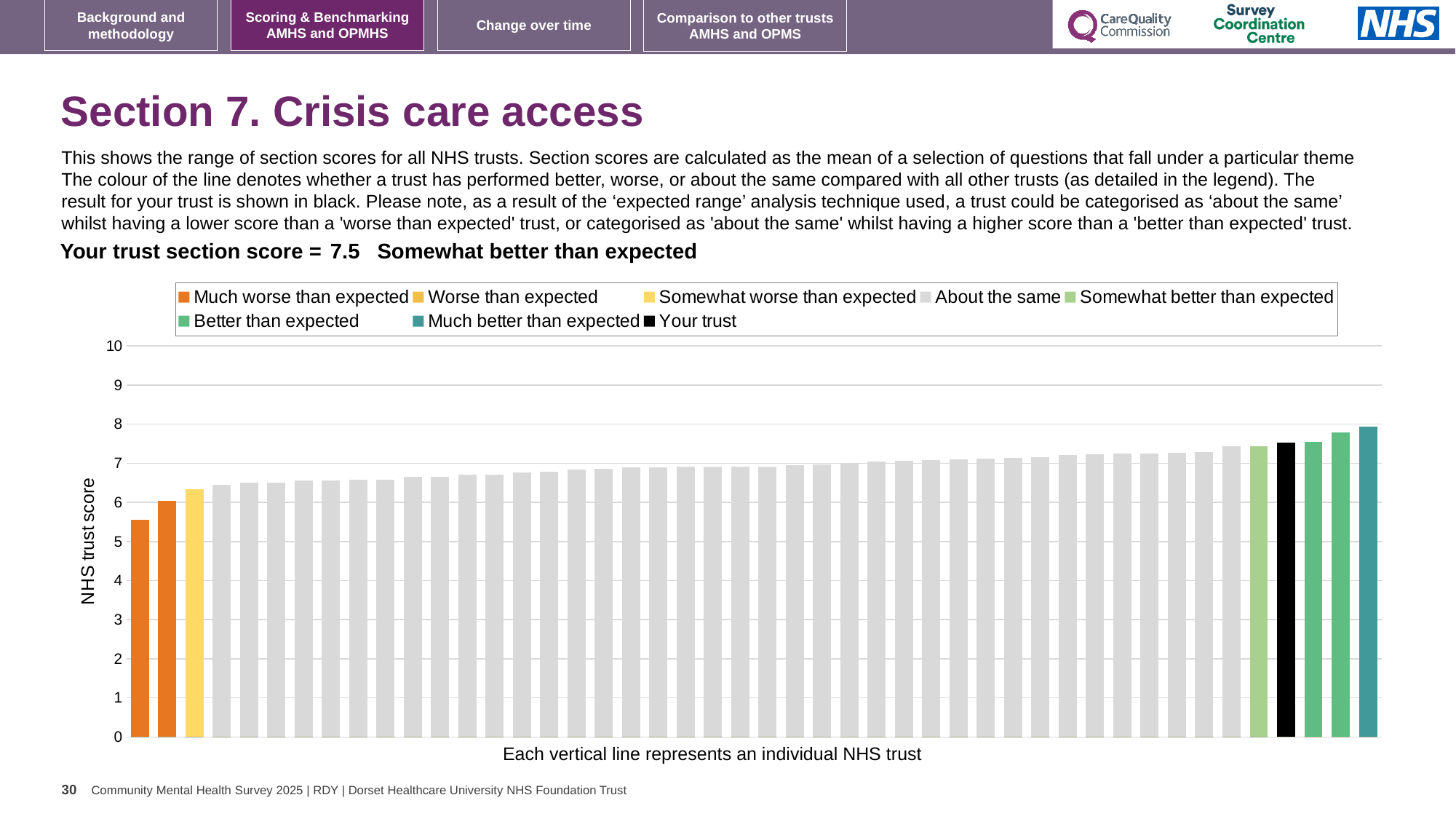
What is the label on the vertical axis of the chart? NHS trust score Is your trust's bar higher or lower than the rightmost bar in the chart? lower Is the value of the highest bar in the chart greater or less than 7? greater Which legend category does the highest bar in the chart belong to? Much better than expected What is the section score for your trust shown on the slide? 7.5 Which legend category is your trust's section score placed in? Somewhat better than expected Is the value for your trust's bar greater or less than 7? greater Which legend category does the lowest bar in the chart belong to? Much worse than expected What kind of chart is shown on the slide? bar chart Is the value of the lowest bar in the chart greater or less than 6? less How many entries does the chart legend list? 8 Do the bar values rise or fall from left to right along the x axis? rise